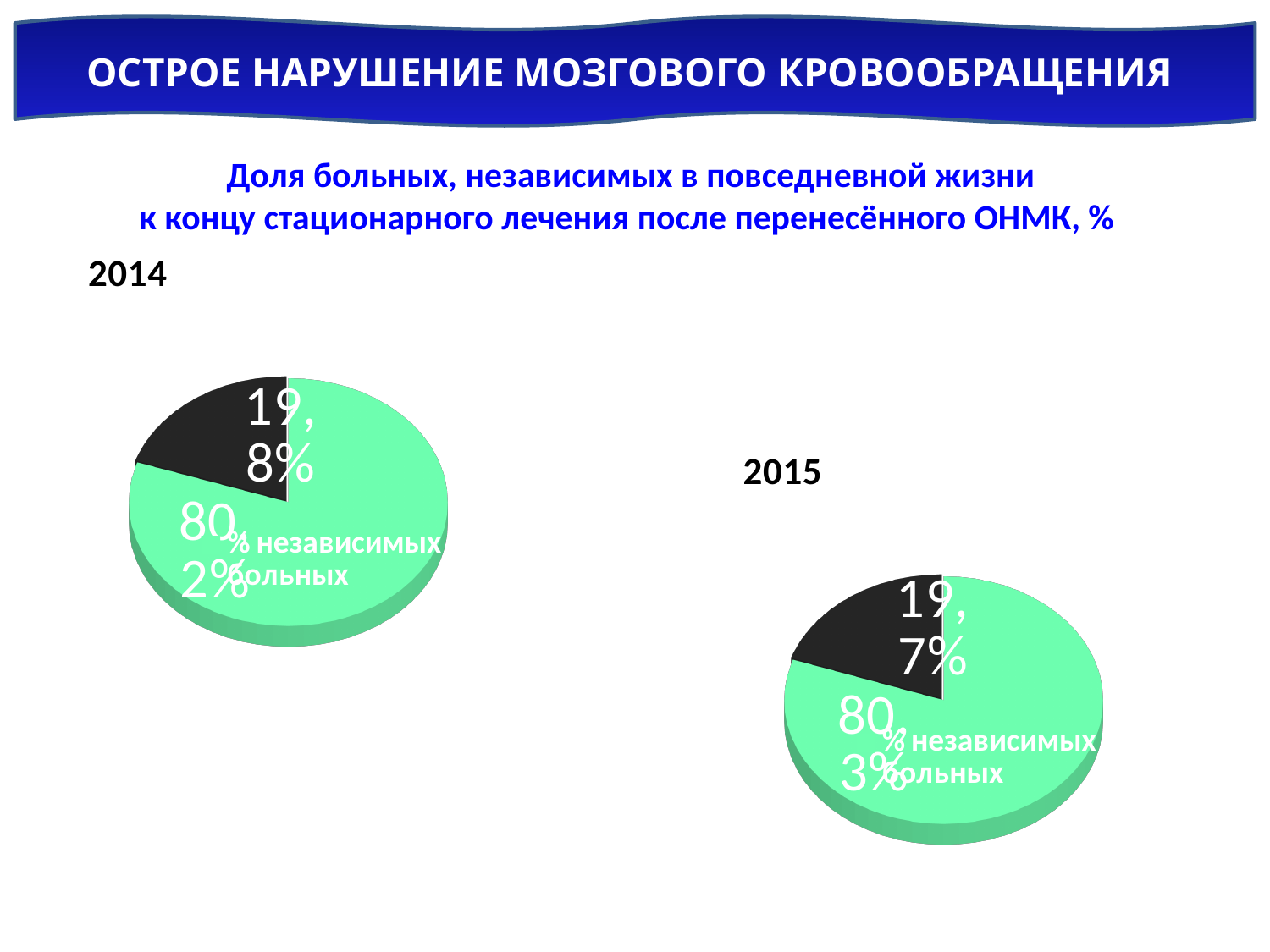
In the 2014 chart, what is the difference between the green slice and the black slice? 60,4 Did the share of independent patients rise or fall from 2014 to 2015? rise In the 2015 chart, what value is shown on the black slice? 19,7% What kind of chart is the 2014 chart? pie chart In the 2014 chart, what is the share of independent patients (% независимых больных)? 80,2% What colour is the slice for independent patients in both charts? green In the 2014 chart, what value is shown on the black slice? 19,8% In the 2014 chart, which slice is the largest? % независимых больных (80,2%) In the 2015 chart, which slice is the smallest? the black slice (19,7%) Which year shows the larger share of independent patients, 2014 or 2015? 2015 In the 2015 chart, what is the share of independent patients (% независимых больных)? 80,3% How many slices does the 2015 pie chart have? 2